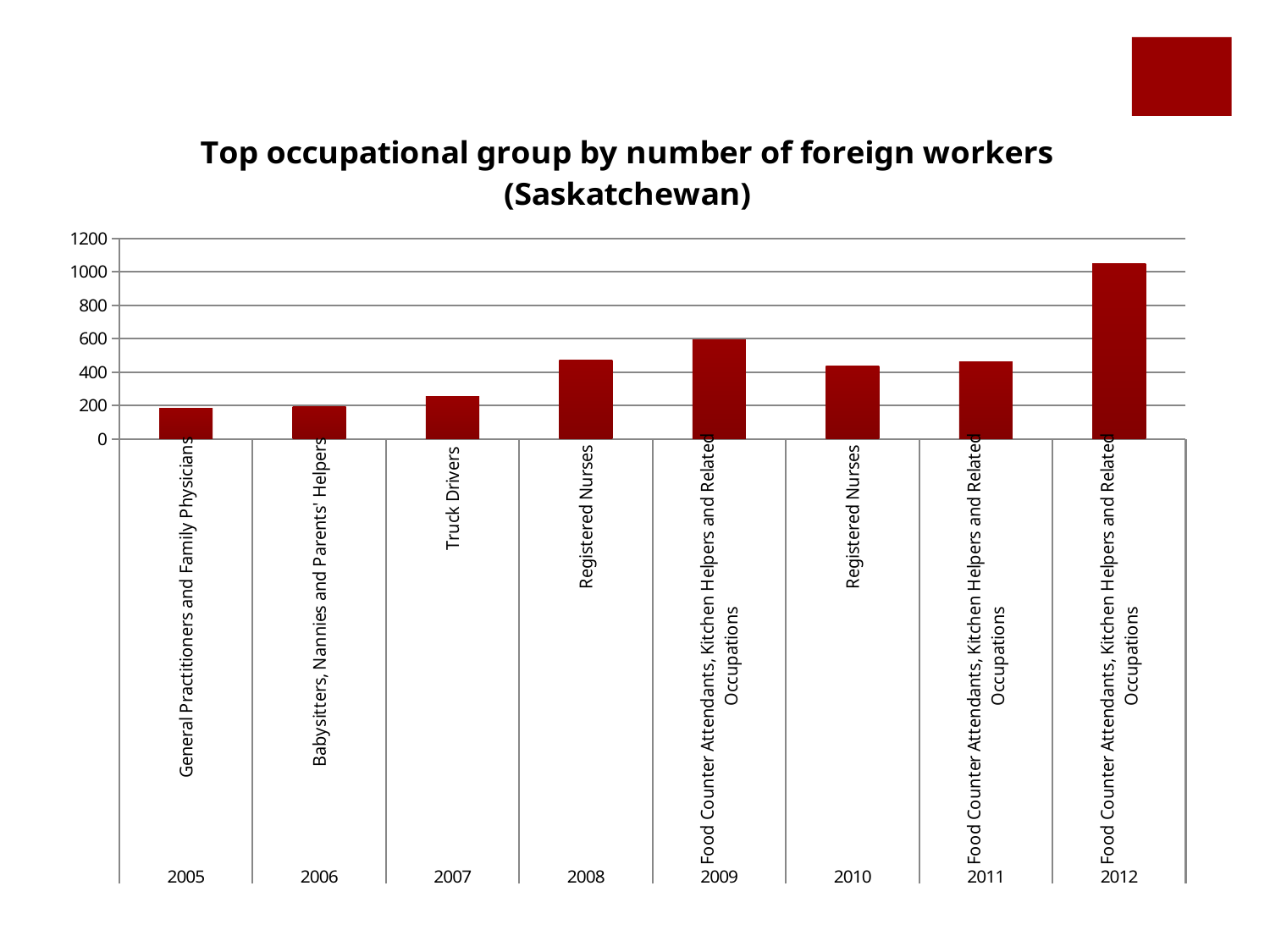
Which is larger, the value for 2009 or the value for 2010? 2009 What is the top occupational group shown for 2007? Truck Drivers What kind of chart is shown on the slide? bar chart Is the value for 2009 greater or less than 400? greater How many years (bars) are plotted in the chart? 8 What is the title of the chart? Top occupational group by number of foreign workers (Saskatchewan) Which year has the highest number of foreign workers in its top occupational group? 2012 Is the value for 2007 greater or less than 200? greater Is the value for 2012 greater or less than 1000? greater Do the values rise or fall from 2005 to 2009? rise